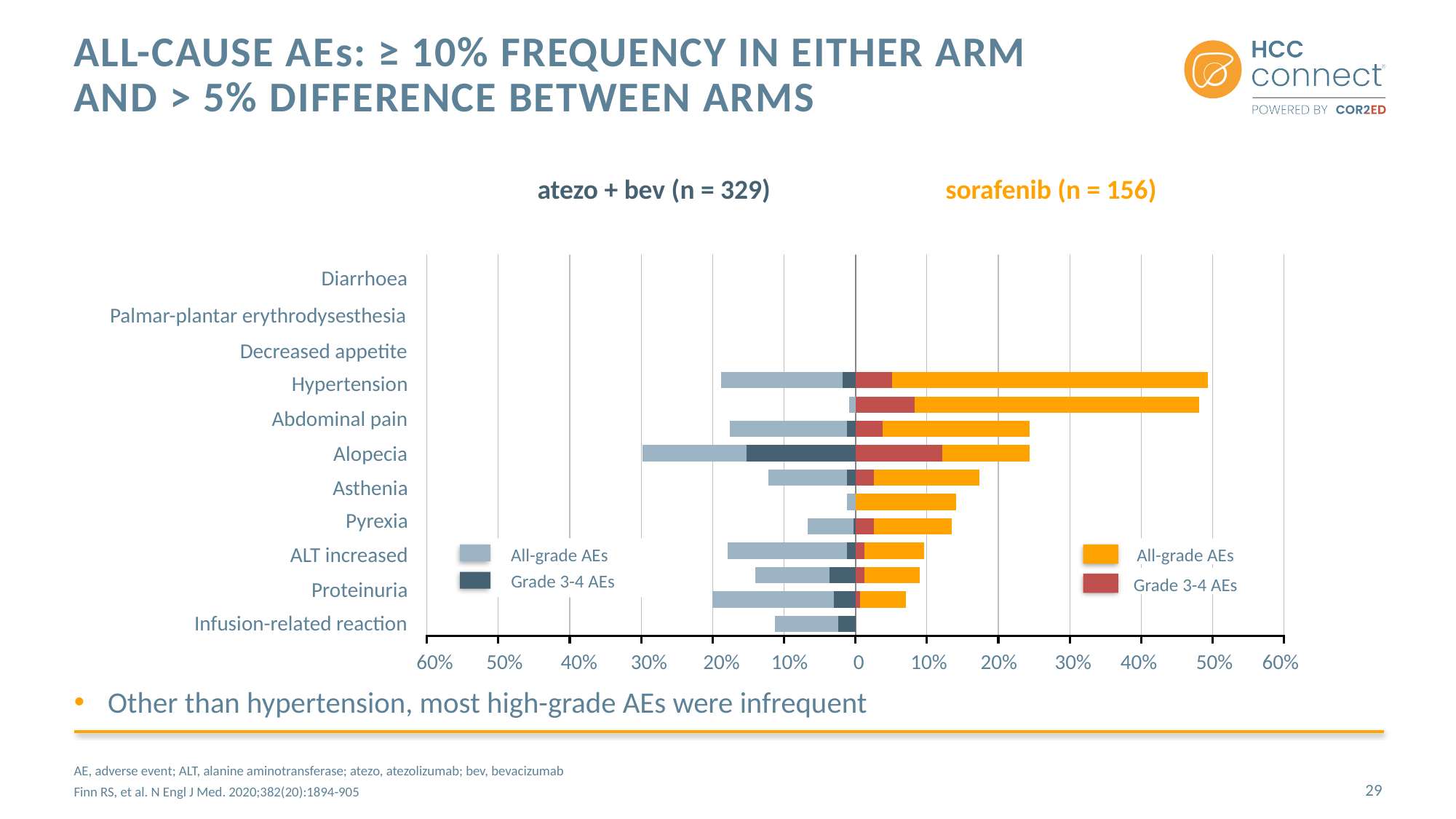
What is the maximum value shown on the horizontal axis on either side of the chart? 60% How many series does the legend for the sorafenib arm list? 2 Which arm has the longest all-grade AE bar in the chart? sorafenib (n = 156) What is the sample size shown for the atezo + bev arm? n = 329 Is the longest all-grade AE bar for the sorafenib arm greater or less than 40%? greater What kind of chart is shown on the slide? bar chart How many adverse event categories are listed on the vertical axis of the chart? 11 How many series does the legend for the atezo + bev arm list? 2 What is the sample size shown for the sorafenib arm? n = 156 Which arm's bars extend to the left of the zero line in the chart? atezo + bev (n = 329) Is the longest all-grade AE bar for the atezo + bev arm greater or less than 40%? less